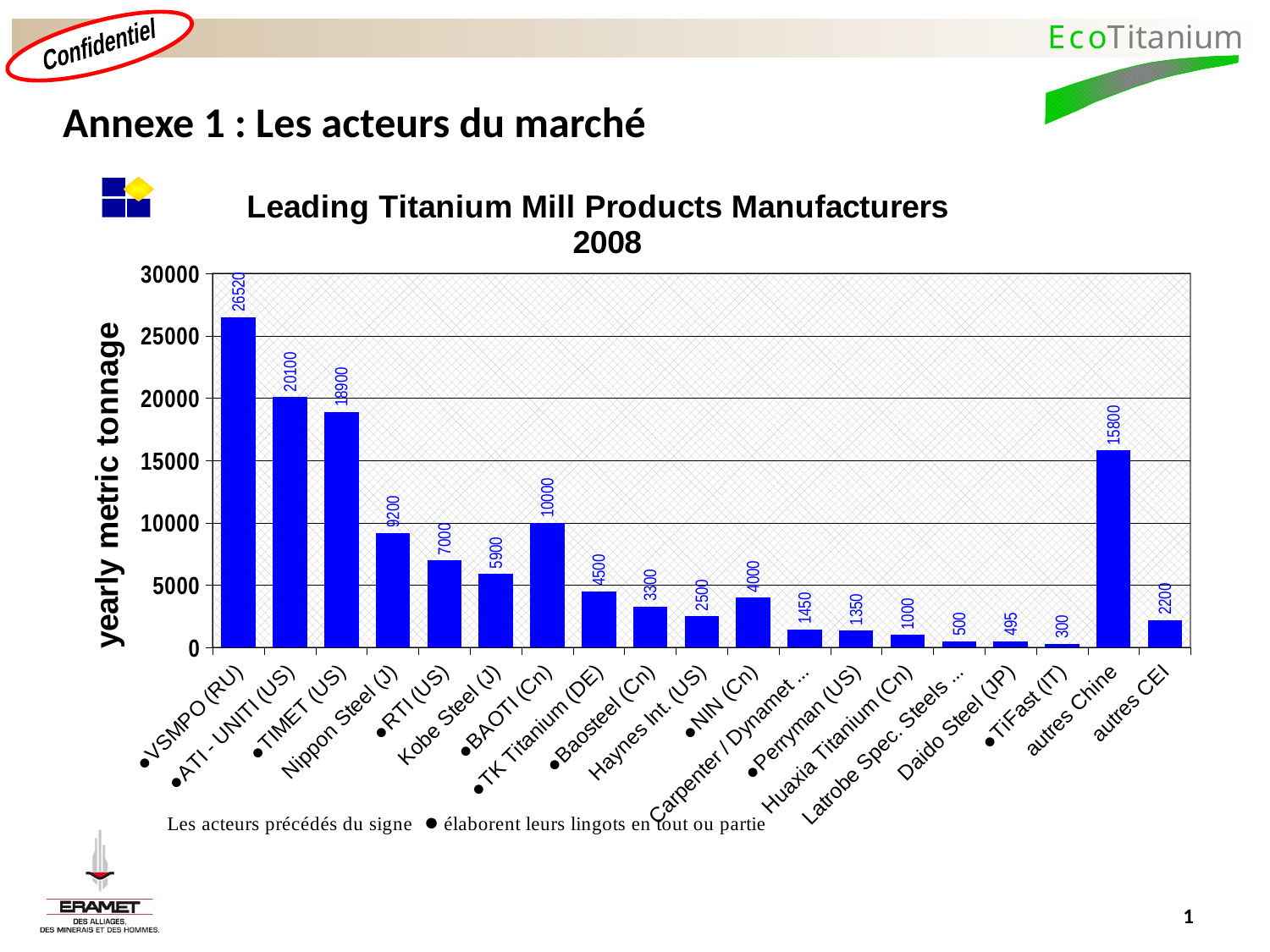
How many manufacturers (categories) are shown on the x axis? 19 What is the yearly metric tonnage for Daido Steel (JP)? 495 What is the yearly metric tonnage for VSMPO (RU)? 26520 Which manufacturer has the lowest yearly metric tonnage? TiFast (IT) What is the yearly metric tonnage for autres Chine? 15800 What is the difference in yearly metric tonnage between TIMET (US) and Nippon Steel (J)? 9700 Which has a larger yearly metric tonnage, Kobe Steel (J) or RTI (US)? RTI (US) What is the yearly metric tonnage for BAOTI (Cn)? 10000 What is the title of the chart? Leading Titanium Mill Products Manufacturers 2008 Which manufacturer has the highest yearly metric tonnage? VSMPO (RU) What kind of chart is shown on the slide? bar chart What is the difference in yearly metric tonnage between VSMPO (RU) and ATI - UNITI (US)? 6420